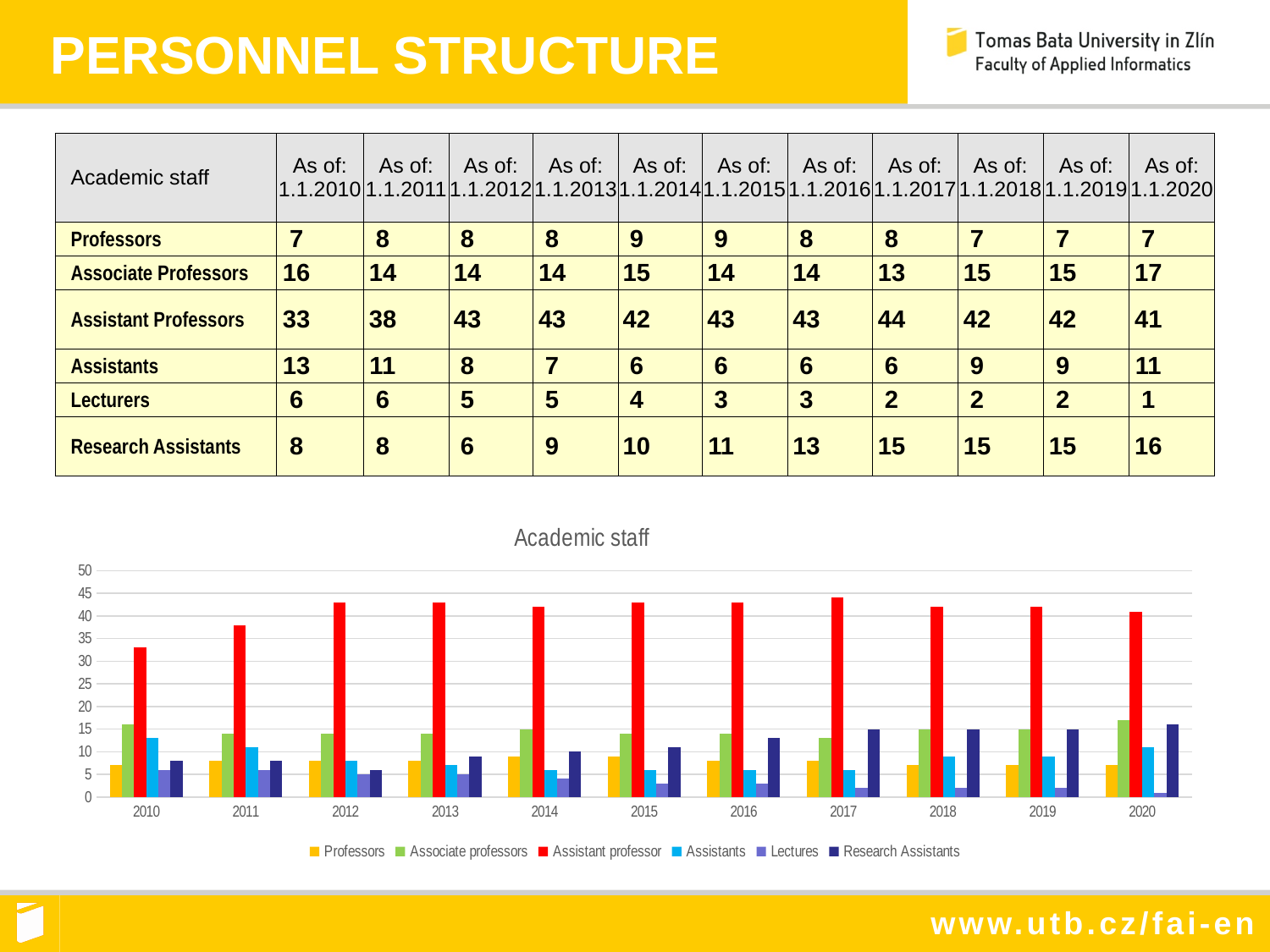
What kind of chart is shown under the table on the slide? bar chart In the Academic staff chart, which series has the tallest bar in 2020? Assistant professor What is the number of Assistant Professors as of 1.1.2017? 44 How many series does the legend of the Academic staff chart list? 6 How many years are shown along the x axis of the Academic staff chart? 11 In 2020, which is larger in the Academic staff chart: Research Assistants or Assistants? Research Assistants In the Academic staff chart, do the Research Assistants values generally rise or fall from 2010 to 2020? rise In the Academic staff chart, is the value for Assistant professor in 2010 greater or less than 30? greater In which year is the Lecturers value lowest? 2020 In the Academic staff chart, do the Lectures values generally rise or fall from 2010 to 2020? fall What is the title of the chart on the slide? Academic staff By how much did the number of Associate Professors change between 1.1.2010 and 1.1.2020? 1